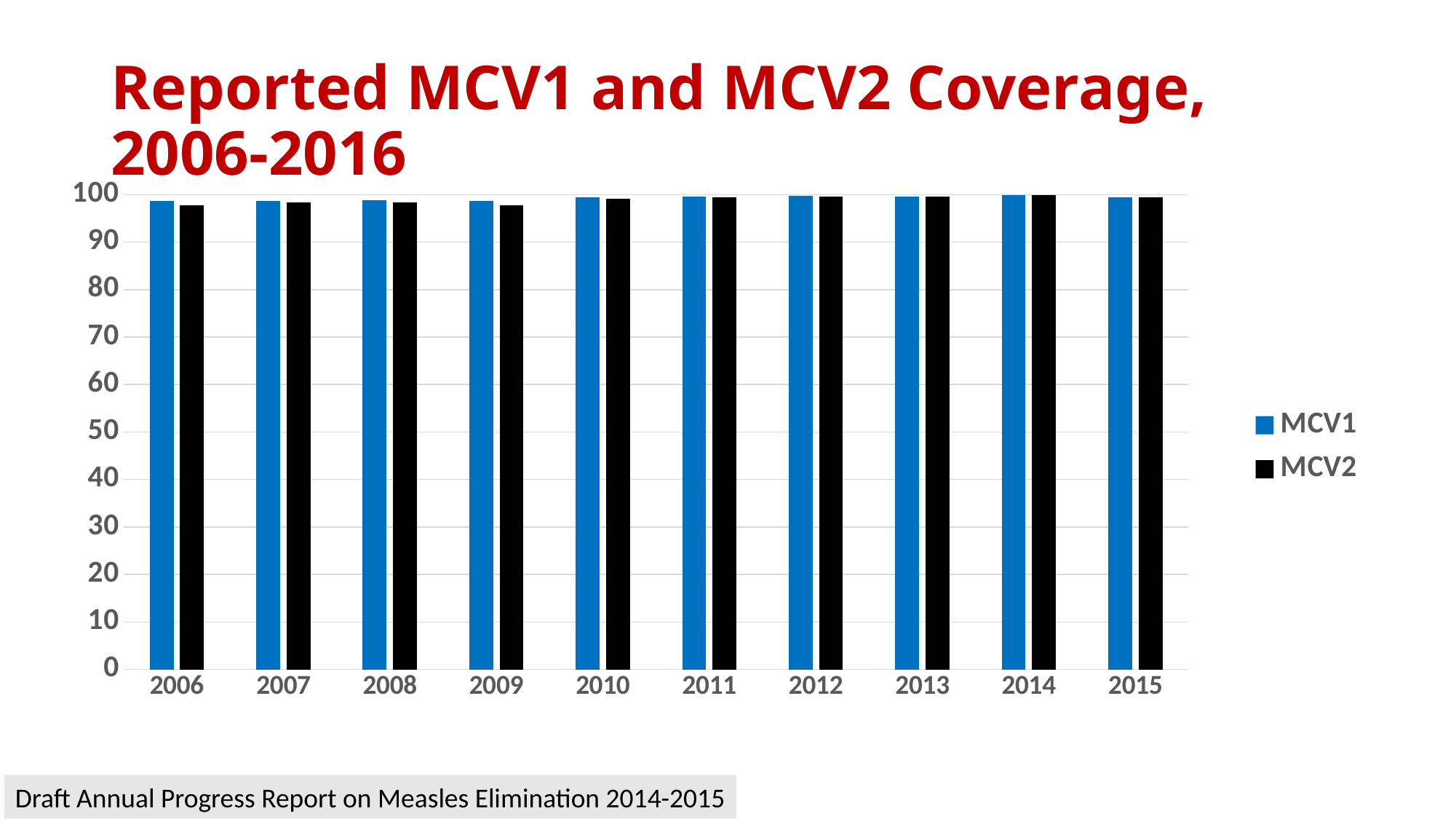
Is the MCV1 value for 2014 greater or less than 80? greater Is the MCV2 value for 2015 greater or less than 50? greater What kind of chart is shown on the slide? bar chart Is the MCV2 value for 2009 greater or less than 90? greater What is the first year shown on the x axis? 2006 Which series is shown in black? MCV2 How many years are shown on the x axis? 10 How many series does the legend list? 2 What is the title of the chart? Reported MCV1 and MCV2 Coverage, 2006-2016